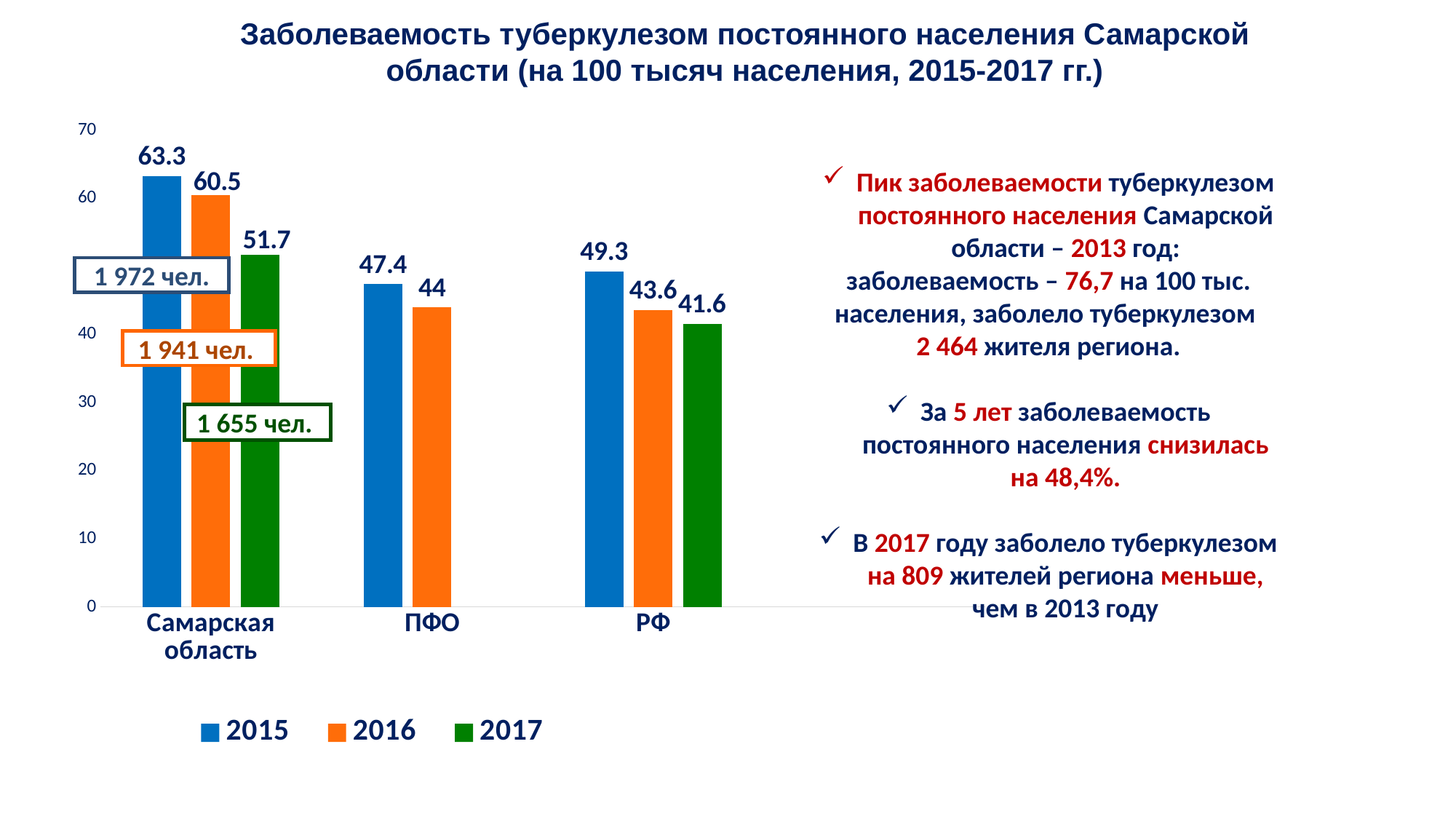
What is the 2016 value for ПФО? 44 What is the 2015 value for Самарская область? 63.3 How many series does the legend list? 3 Which category has the highest 2015 value? Самарская область What kind of chart is shown on the slide? bar chart Is the 2016 value for Самарская область greater or less than 60? greater Which category has the lowest 2016 value? РФ What is the 2017 value for РФ? 41.6 Do the values for РФ rise or fall from 2015 to 2017? fall How many categories are shown on the x axis? 3 What is the difference between the 2015 and 2017 values for Самарская область? 11.6 Which is larger: the 2015 value for ПФО or the 2015 value for РФ? РФ